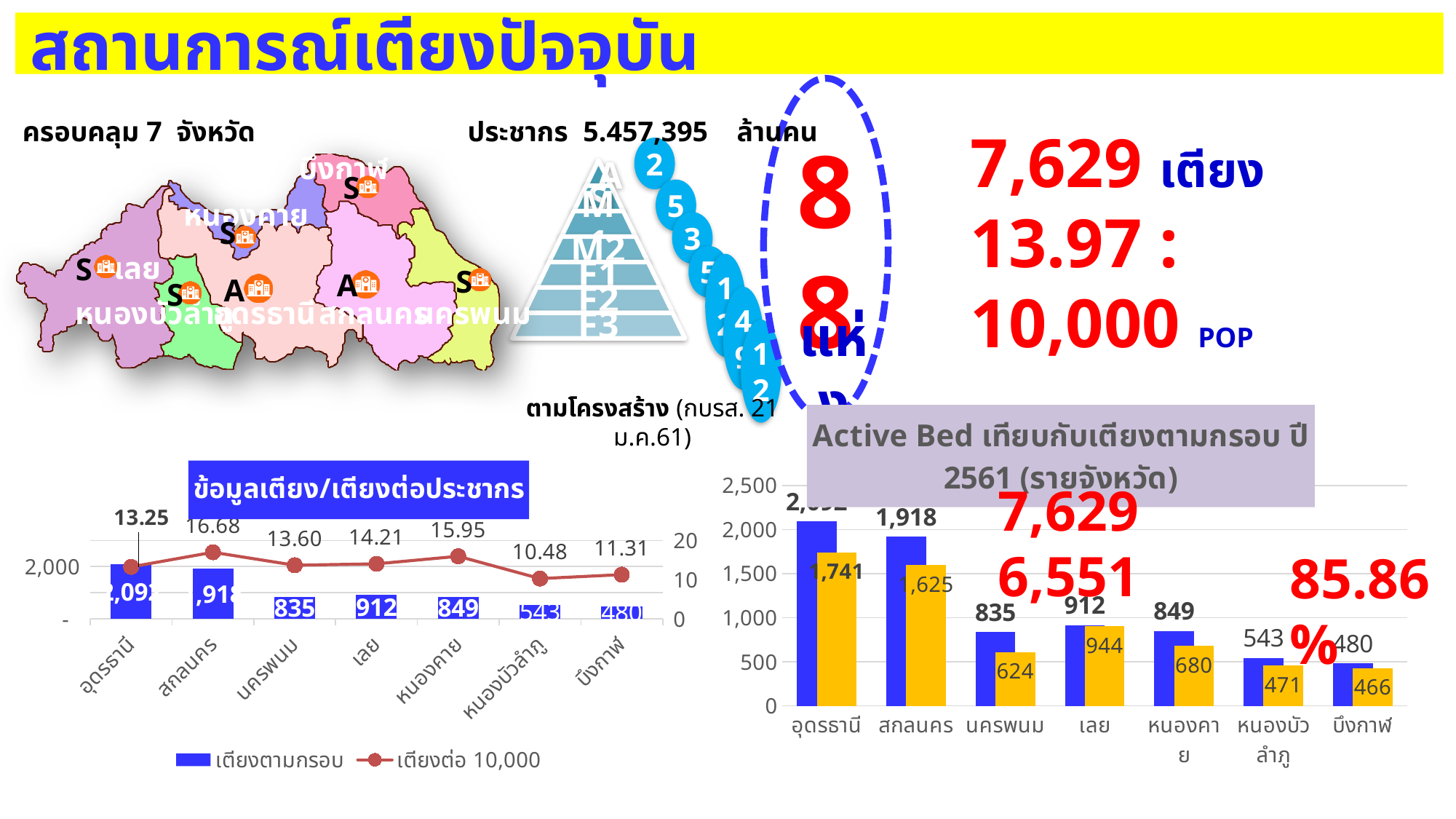
In the left chart (ข้อมูลเตียง/เตียงต่อประชากร), what is the เตียงต่อ 10,000 value for สกลนคร? 16.68 In the left chart (ข้อมูลเตียง/เตียงต่อประชากร), what is the difference between the เตียงตามกรอบ values for เลย and หนองคาย? 63 In the right chart (Active Bed เทียบกับเตียงตามกรอบ ปี 2561), is the blue bar for สกลนคร greater or less than 1,500? greater In the left chart (ข้อมูลเตียง/เตียงต่อประชากร), which province has the lowest เตียงต่อ 10,000 value? หนองบัวลำภู In the left chart (ข้อมูลเตียง/เตียงต่อประชากร), which province has the highest เตียงต่อ 10,000 value? สกลนคร What kind of chart is the right chart (Active Bed เทียบกับเตียงตามกรอบ ปี 2561)? bar chart In the right chart (Active Bed เทียบกับเตียงตามกรอบ ปี 2561), what is the value of the orange bar for เลย? 944 In the left chart (ข้อมูลเตียง/เตียงต่อประชากร), what is the เตียงตามกรอบ value for นครพนม? 835 In the right chart (Active Bed เทียบกับเตียงตามกรอบ ปี 2561), what is the difference between the blue bar and the orange bar for นครพนม? 211 In the left chart (ข้อมูลเตียง/เตียงต่อประชากร), how many provinces are shown on the x axis? 7 In the left chart (ข้อมูลเตียง/เตียงต่อประชากร), how many series does the legend list? 2